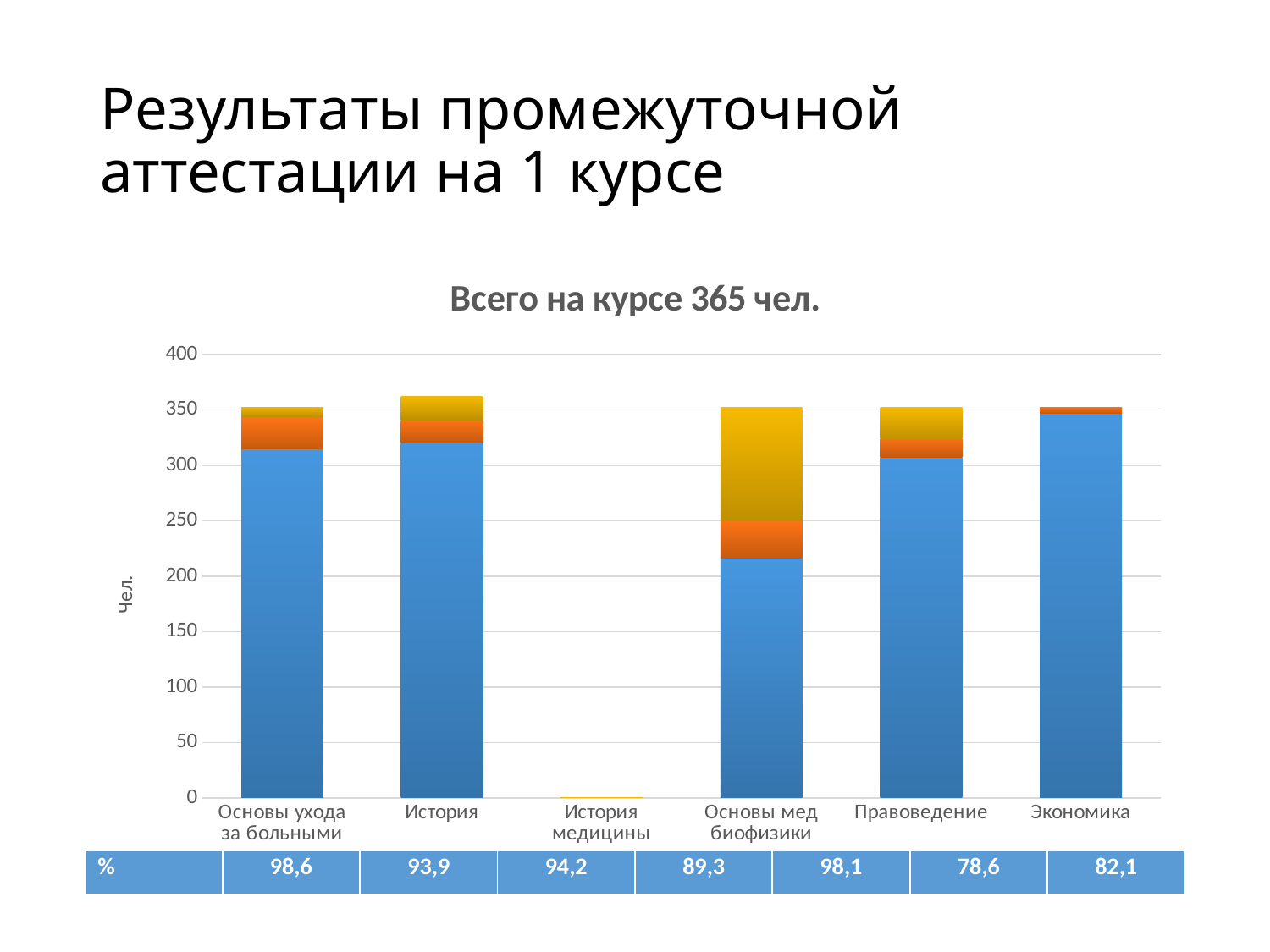
Which category has the lowest total bar height? История медицины Is the blue segment for Правоведение greater or less than 250? greater Is the blue segment for Основы мед биофизики greater or less than 250? less What kind of chart is shown on the slide? bar chart Is the total height of the bar for История greater or less than 350? greater Which has the larger blue segment, Основы ухода за больными or Основы мед биофизики? Основы ухода за больными What is the title of the chart? Всего на курсе 365 чел. What is the label of the vertical axis of the chart? Чел. How many categories are shown on the x axis of the chart? 6 Which category has the largest yellow (top) segment? Основы мед биофизики